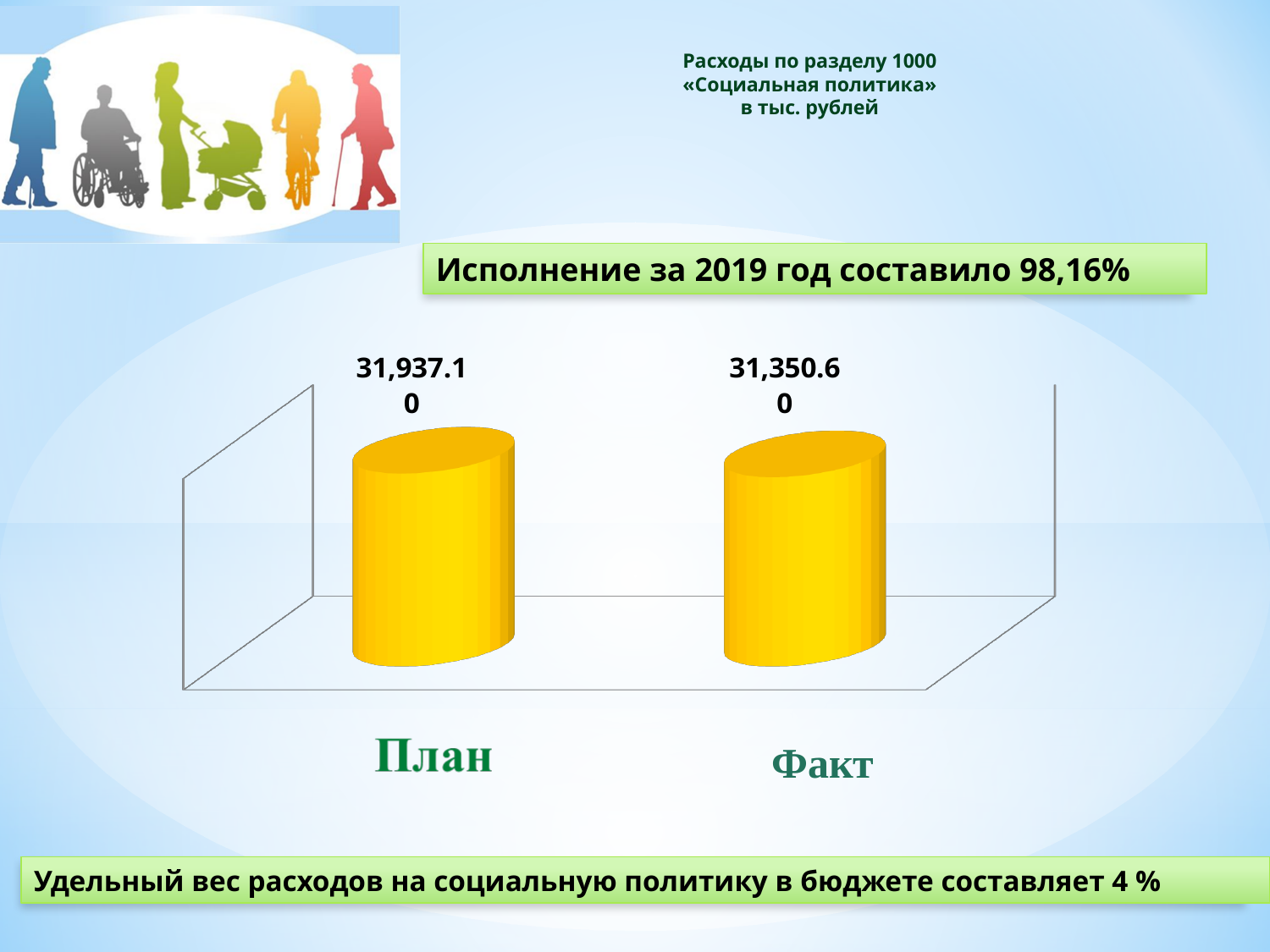
How many categories are shown in the chart? 2 What is the value for Факт? 31,350.60 Do the values rise or fall from План to Факт? Fall Which category has the higher value, План or Факт? План What colour are the bars in the chart? Yellow What is the difference between the values for План and Факт? 586.50 What is the value for План? 31,937.10 Which category has the highest value? План What kind of chart is shown on the slide? Bar chart In what units are the chart values given, according to the slide title? тыс. рублей Which category has the lowest value? Факт